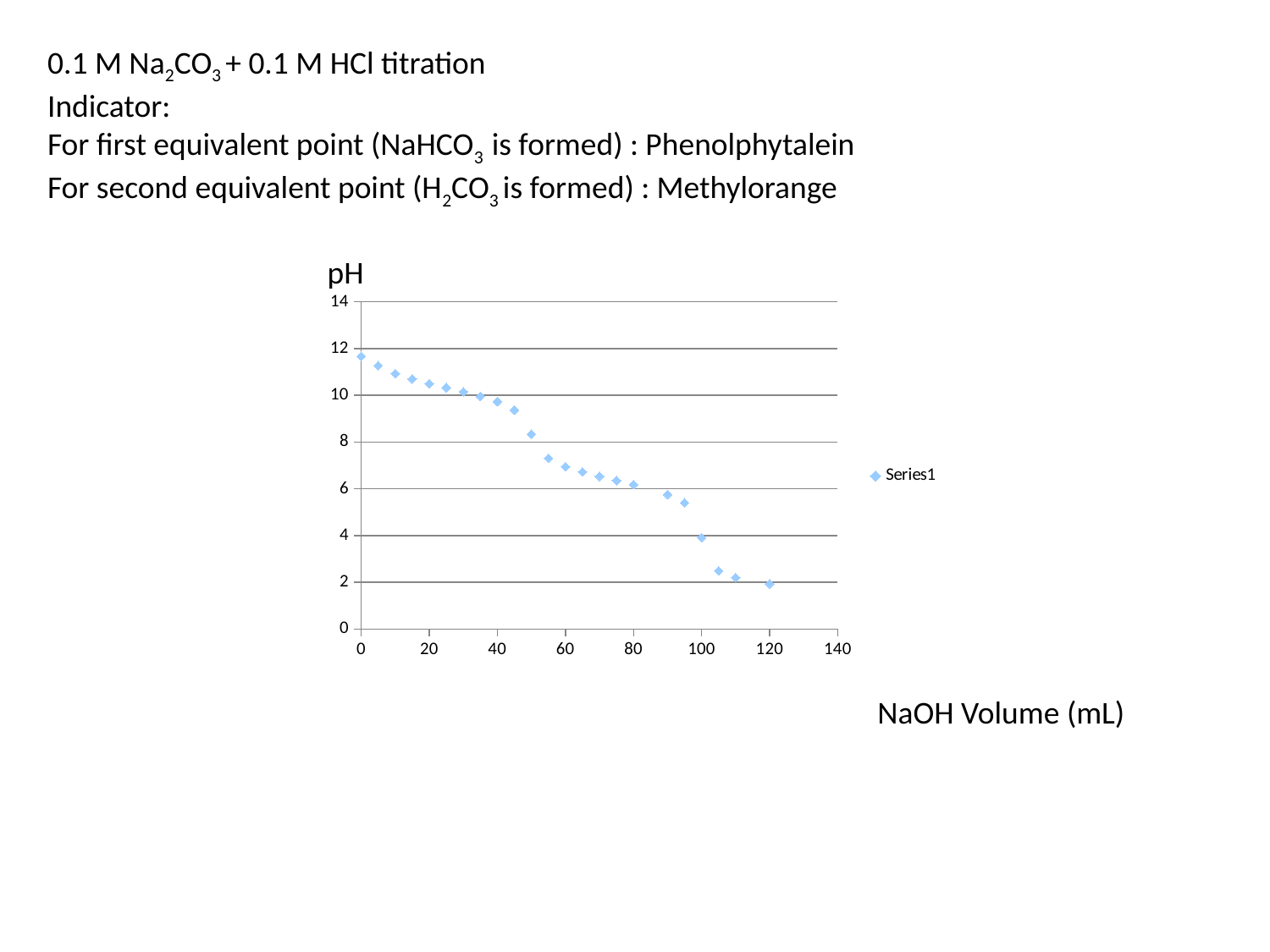
What is the label of the vertical axis? pH Is the pH at 50 mL NaOH greater or less than 6? greater Is the pH at 100 mL NaOH greater or less than 6? less At which NaOH volume is the pH highest? 0 Do the pH values rise or fall as NaOH volume increases along the x axis? fall What is the legend entry for the plotted series? Series1 At which NaOH volume is the pH lowest? 120 Is the pH at 120 mL NaOH greater or less than 4? less What kind of chart is shown on the slide? scatter chart How many series does the legend list? 1 Which has the higher pH: 20 mL NaOH or 80 mL NaOH? 20 mL NaOH